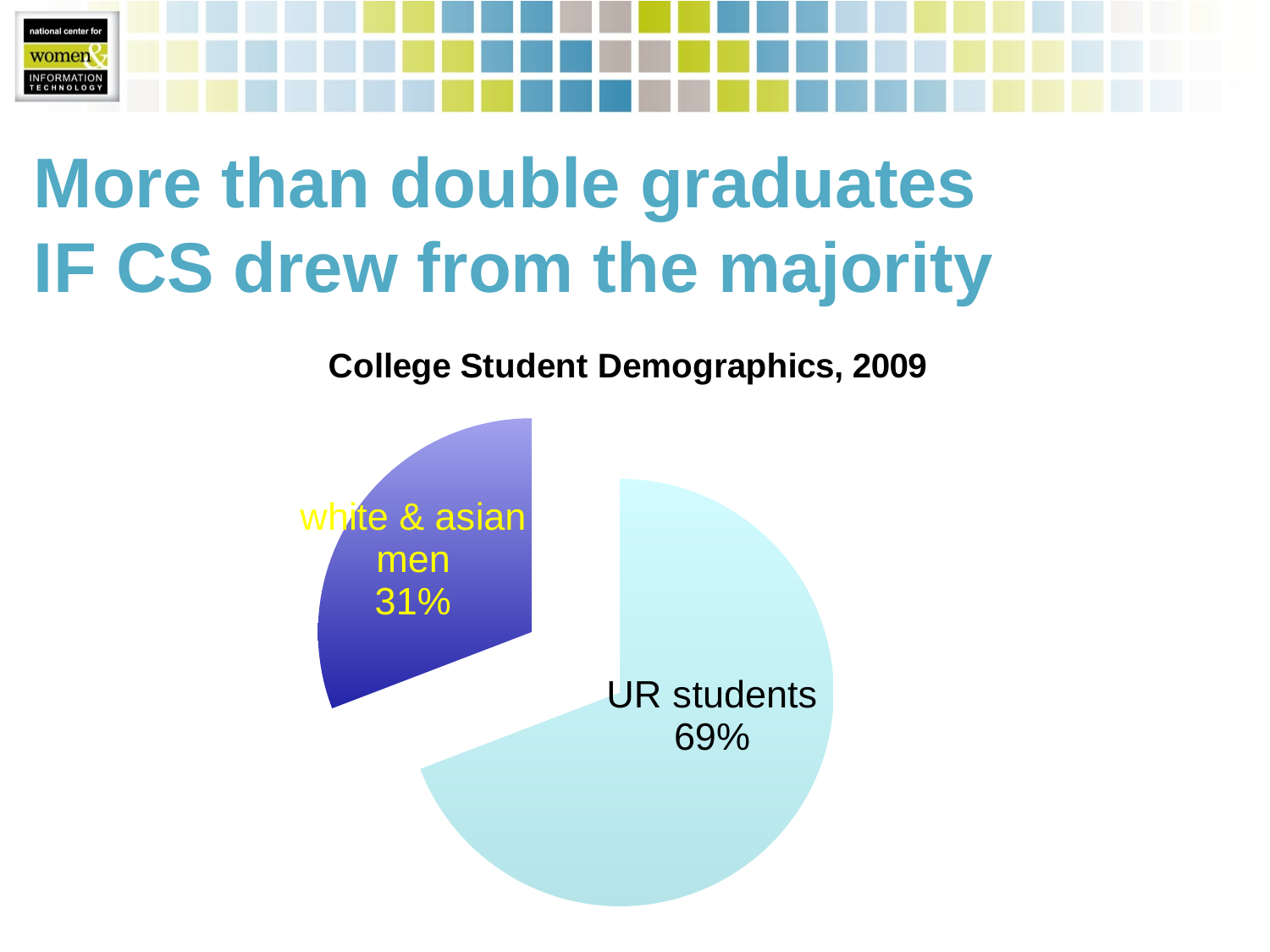
What is the total of the two slice percentages shown? 100% Which is larger, the UR students slice or the white & asian men slice? UR students What share of the pie is labelled white & asian men? 31% What is the difference in percentage points between the UR students slice and the white & asian men slice? 38 What share of the pie is labelled UR students? 69% Which slice of the pie is the largest? UR students Which slice of the pie is the smallest? white & asian men What is the title of the chart? College Student Demographics, 2009 What colour is the UR students slice? light blue Is the share for white & asian men greater or less than 50%? less What kind of chart is shown on the slide? pie chart How many slices does the pie chart have? 2